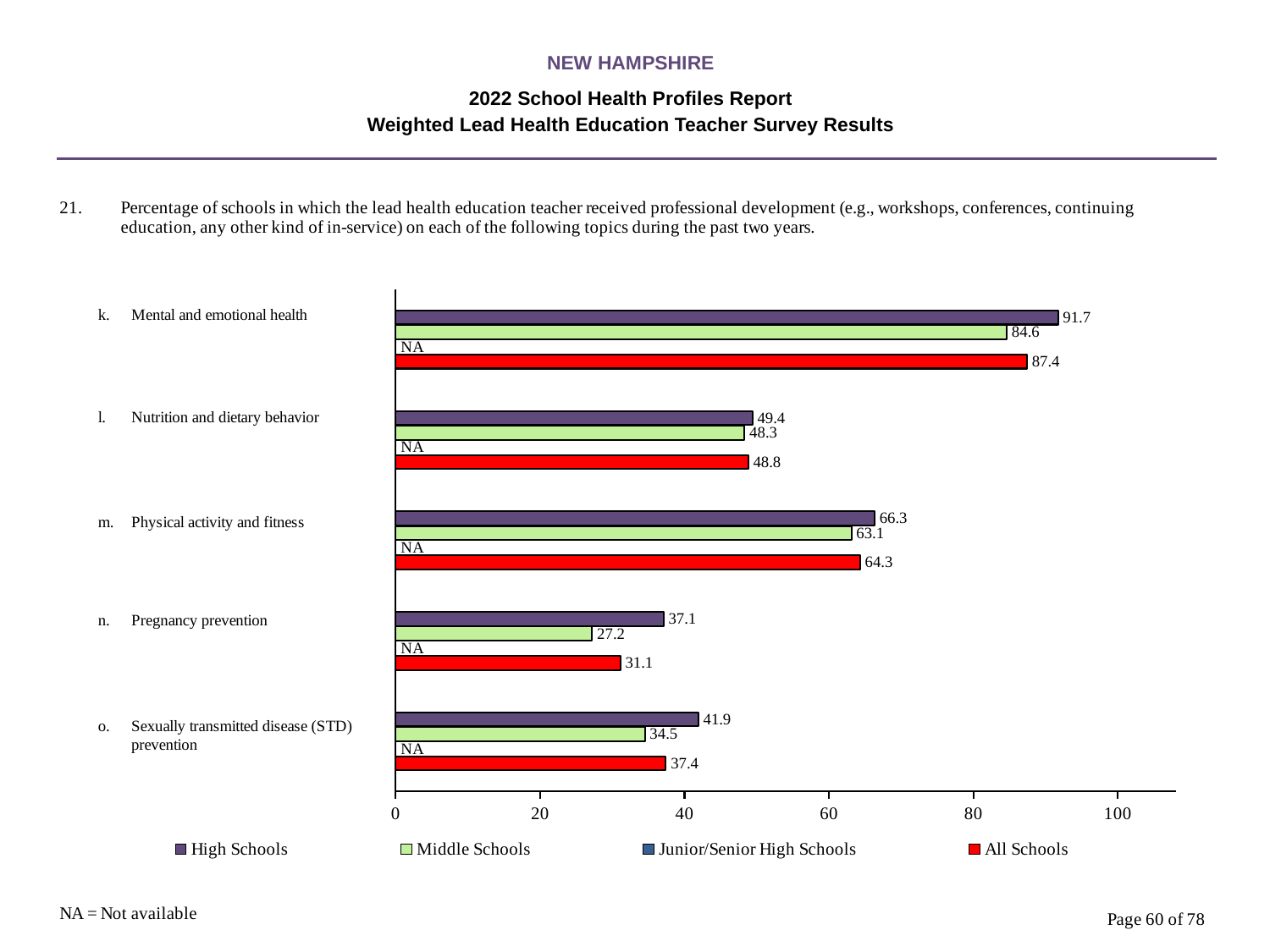
Is the All Schools value for Nutrition and dietary behavior greater or less than 60? less Which topic has the lowest Middle Schools value? Pregnancy prevention What is the All Schools value for Pregnancy prevention? 31.1 What value is shown for Junior/Senior High Schools for each topic? NA How many topics are shown on the chart? 5 How many series does the legend list? 4 What kind of chart is shown on the slide? bar chart What is the difference between the High Schools and Middle Schools values for Pregnancy prevention? 9.9 Which topic has the highest All Schools value? Mental and emotional health What is the High Schools value for Mental and emotional health? 91.7 What is the Middle Schools value for Sexually transmitted disease (STD) prevention? 34.5 Which is larger for Physical activity and fitness: the High Schools value or the All Schools value? High Schools